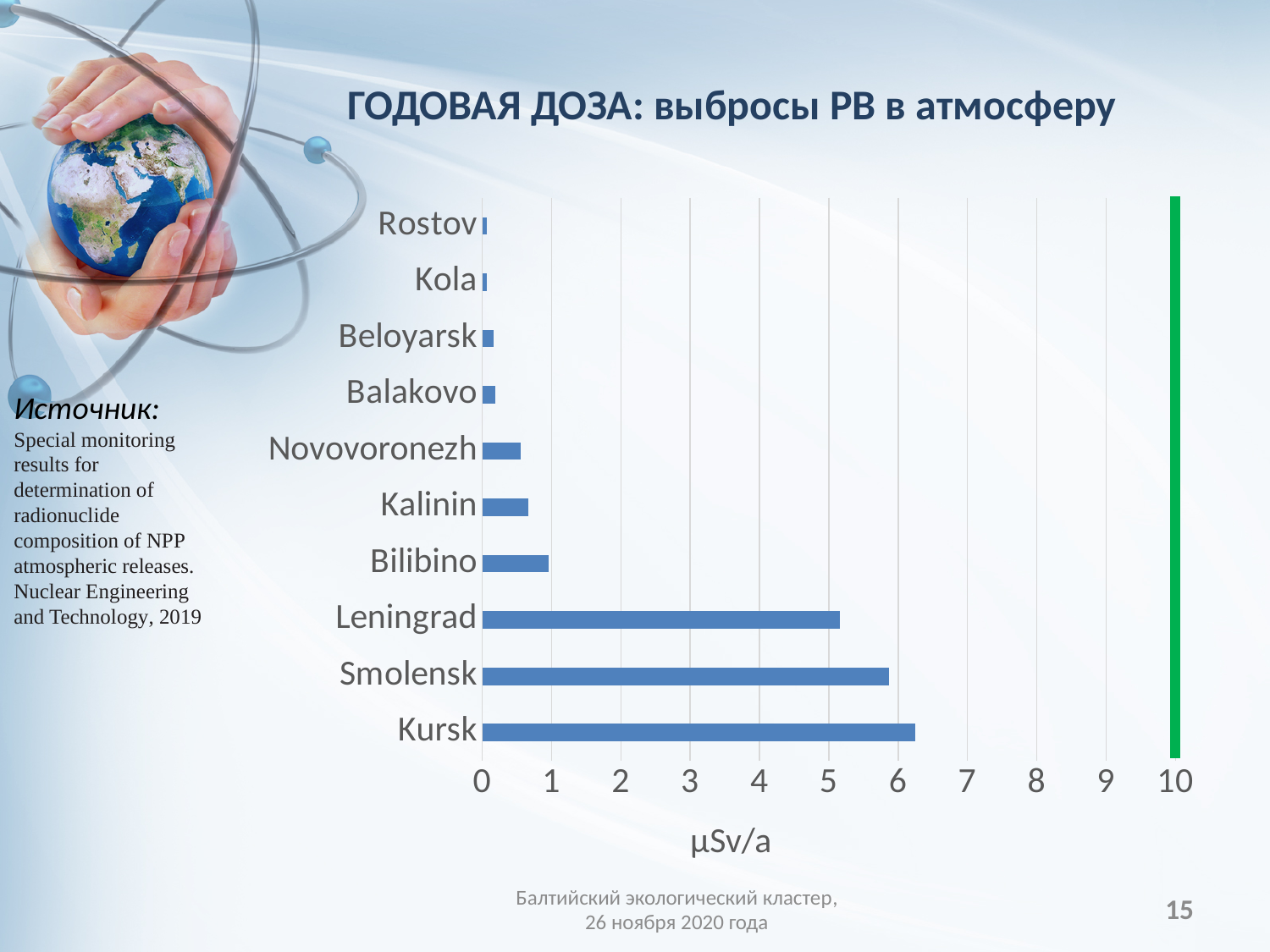
What is the title of the slide containing the chart? ГОДОВАЯ ДОЗА: выбросы РВ в атмосферу Which has a larger value, Smolensk or Bilibino? Smolensk What kind of chart is shown on the slide? bar chart Which has a larger value, Kursk or Leningrad? Kursk Is the value for Leningrad greater or less than 5? greater Which plant has the highest annual dose value in the chart? Kursk Is the value for Kursk greater or less than 6? greater How many nuclear power plants (categories) are plotted in the chart? 10 Is the value for Smolensk greater or less than 5? greater What unit is shown on the horizontal axis of the chart? µSv/a